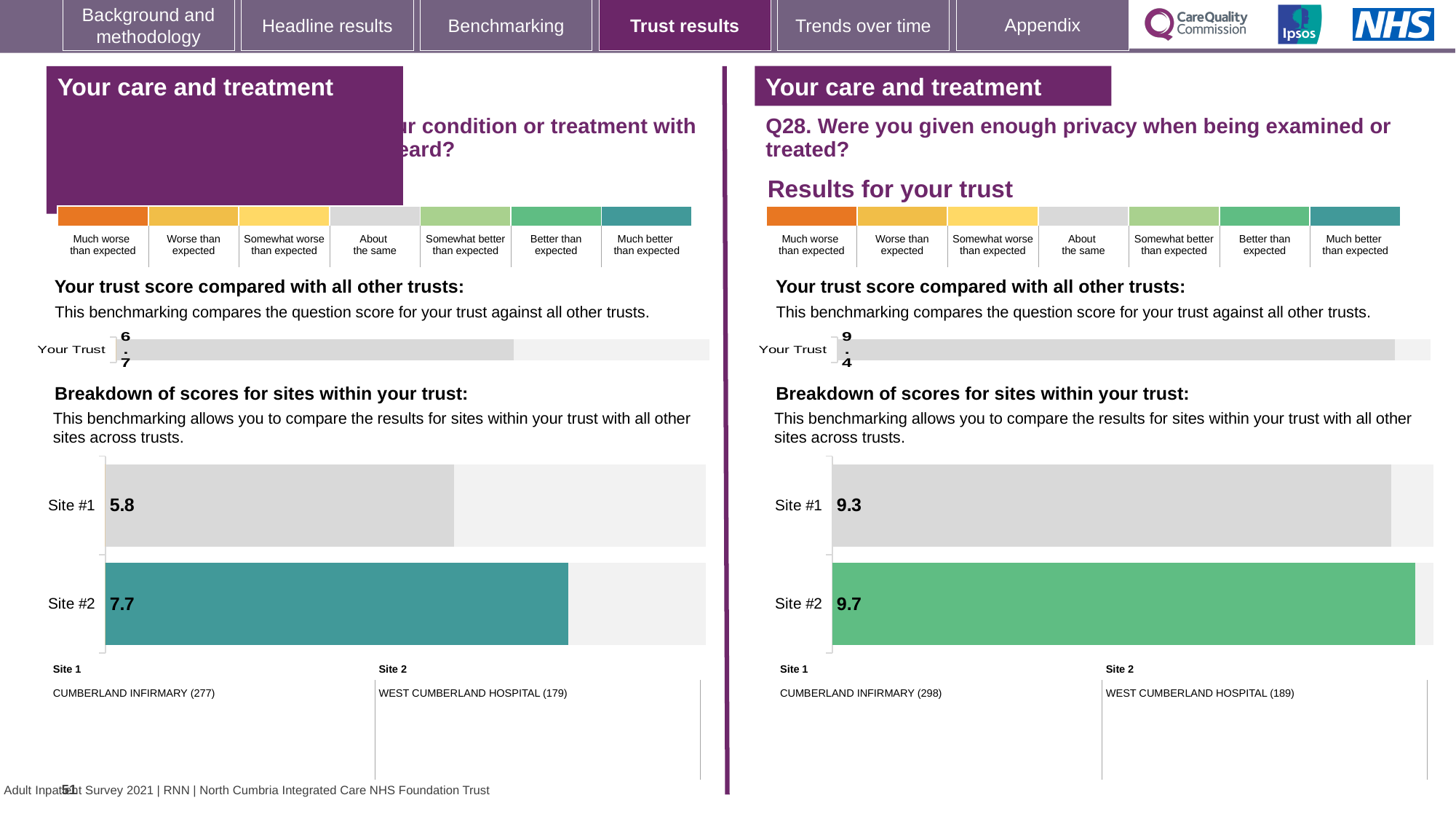
On the left-hand 'Breakdown of scores for sites within your trust' chart, what is the score for Site #1? 5.8 On the right-hand (Q28) 'Breakdown of scores for sites within your trust' chart, what is the score for Site #2? 9.7 On the left-hand 'Your trust score compared with all other trusts' chart, what is the score shown for Your Trust? 6.7 On the right-hand (Q28) 'Your trust score compared with all other trusts' chart, what is the score shown for Your Trust? 9.4 On the left-hand site breakdown chart, what is the difference between the Site #2 and Site #1 scores? 1.9 On the right-hand (Q28) 'Breakdown of scores for sites within your trust' chart, what is the score for Site #1? 9.3 On the left-hand site breakdown chart, which site has the higher score? Site #2 On the right-hand (Q28) site breakdown chart, which site has the lower score? Site #1 On the right-hand (Q28) site breakdown chart, what is the difference between the Site #2 and Site #1 scores? 0.4 On the left-hand 'Breakdown of scores for sites within your trust' chart, what is the score for Site #2? 7.7 What type of chart is used for the site breakdown on the right-hand (Q28) side of the slide? Bar chart How many sites are shown in the left-hand 'Breakdown of scores for sites within your trust' chart? 2